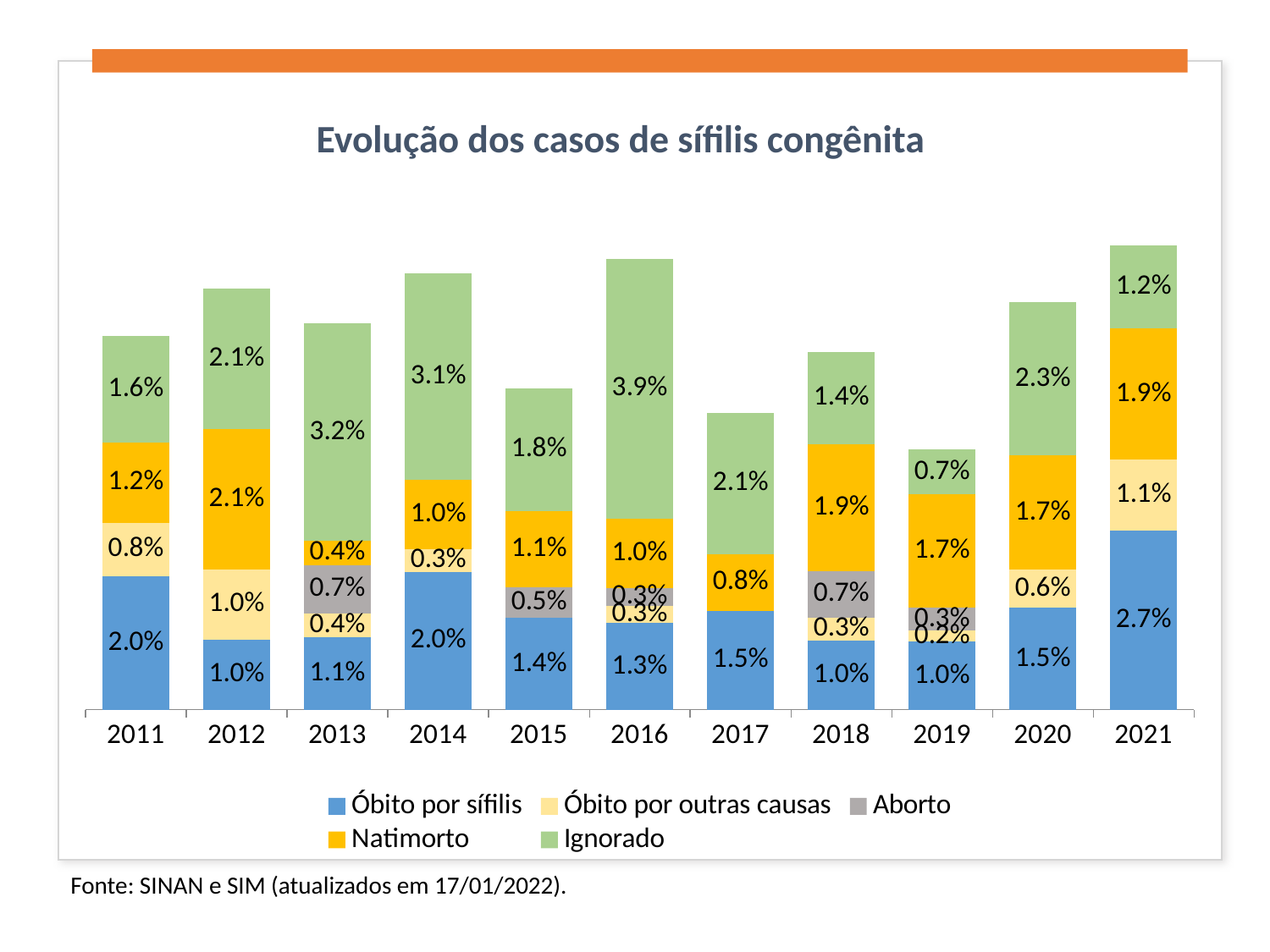
What type of chart is shown on the slide? Stacked bar chart What is the difference between the Natimorto values for 2012 and 2013? 1.7 percentage points Which year has the larger Ignorado value, 2014 or 2015? 2014 What is the value for Natimorto in 2018? 1.9% How many series does the legend list? 5 What is the title of the chart? Evolução dos casos de sífilis congênita In which year is the Ignorado segment the smallest? 2019 What is the value for Aborto in 2013? 0.7% What is the value for Óbito por sífilis in 2021? 2.7% In which year is the Ignorado segment the largest? 2016 What is the value for Ignorado in 2016? 3.9% How many years are shown on the x axis of the chart? 11